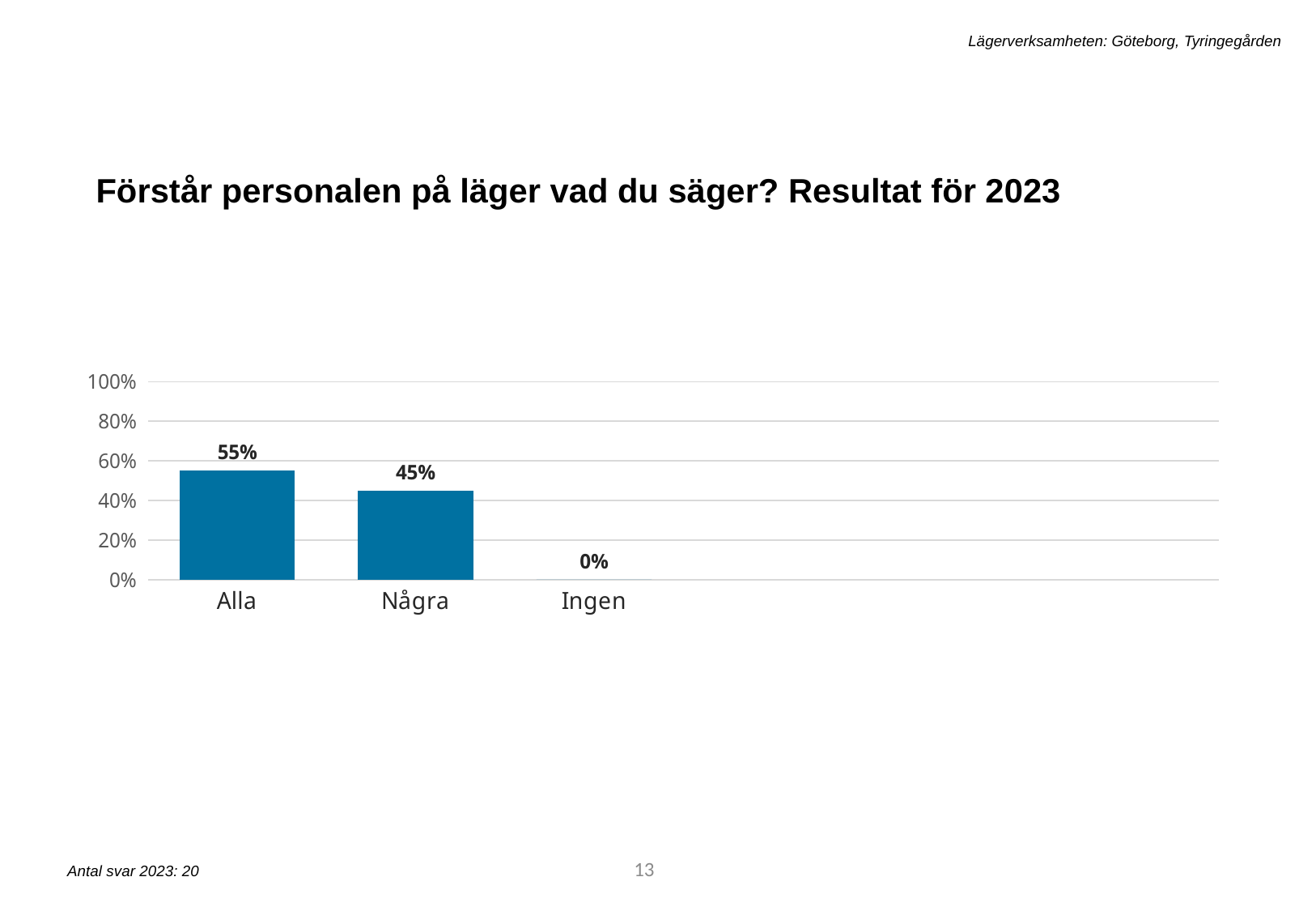
What is the title of the slide above the chart? Förstår personalen på läger vad du säger? Resultat för 2023 Which is larger, the value for Alla or the value for Några? Alla Is the value for Alla greater or less than 40%? greater What is the difference between the values for Alla and Några? 10% What is the value for Några? 45% Which category has the highest value? Alla Is the value for Några greater or less than 60%? less What kind of chart is shown on the slide? bar chart How many categories are shown on the x axis? 3 What is the value for Alla? 55% What is the value for Ingen? 0% Which category has the lowest value? Ingen